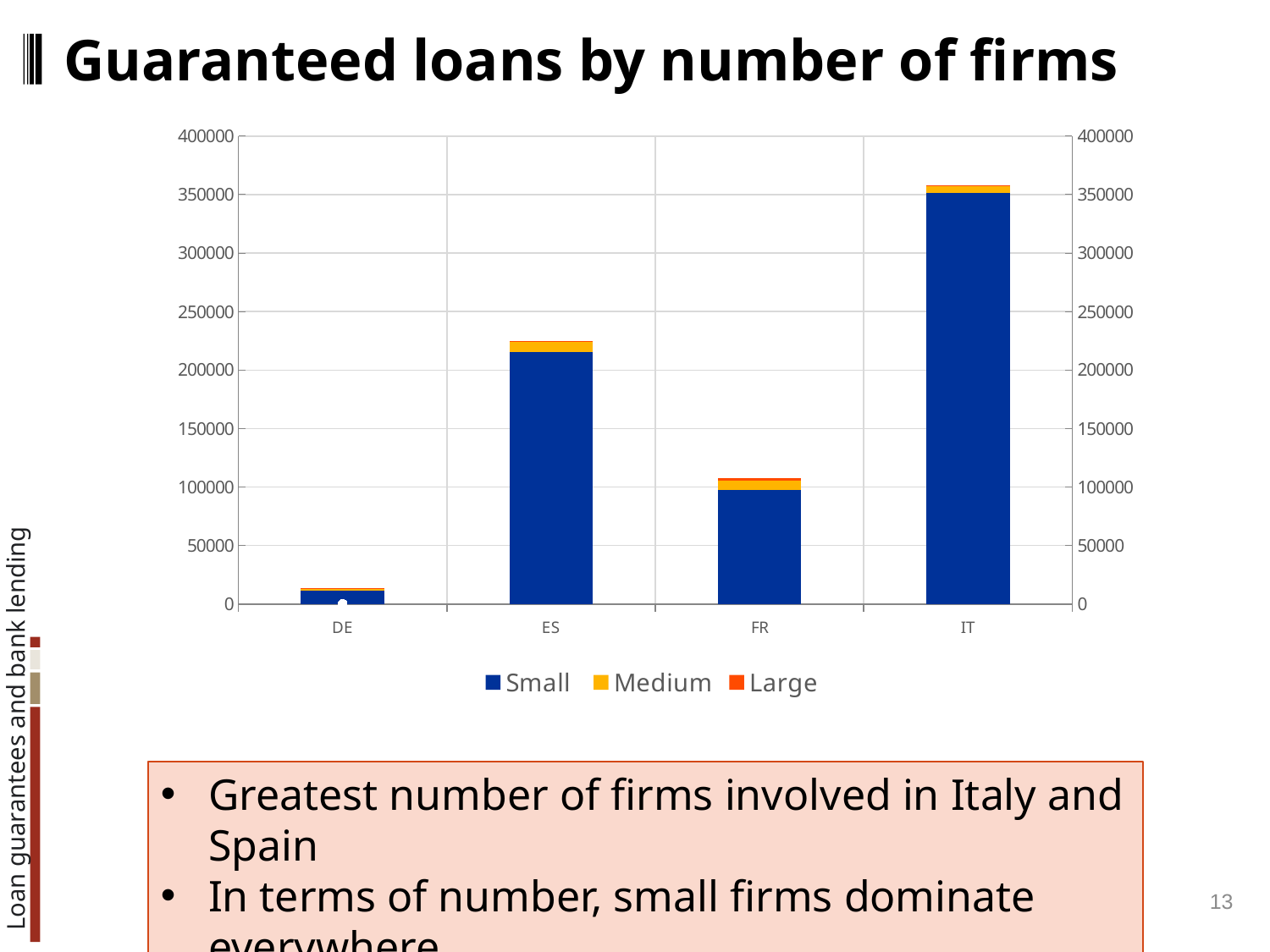
What is the title of the chart on the slide? Guaranteed loans by number of firms Which bar is taller, DE or FR? FR How many series does the chart's legend list? 3 What kind of chart is shown on the slide? bar chart How many countries are shown on the x axis of the chart? 4 Is the total bar height for FR greater or less than 150000? less Which country has the shortest bar in the chart? DE Is the total bar height for DE greater or less than 50000? less Which bar is taller, ES or FR? ES Is the total bar height for ES greater or less than 200000? greater Which country has the tallest bar in the chart? IT